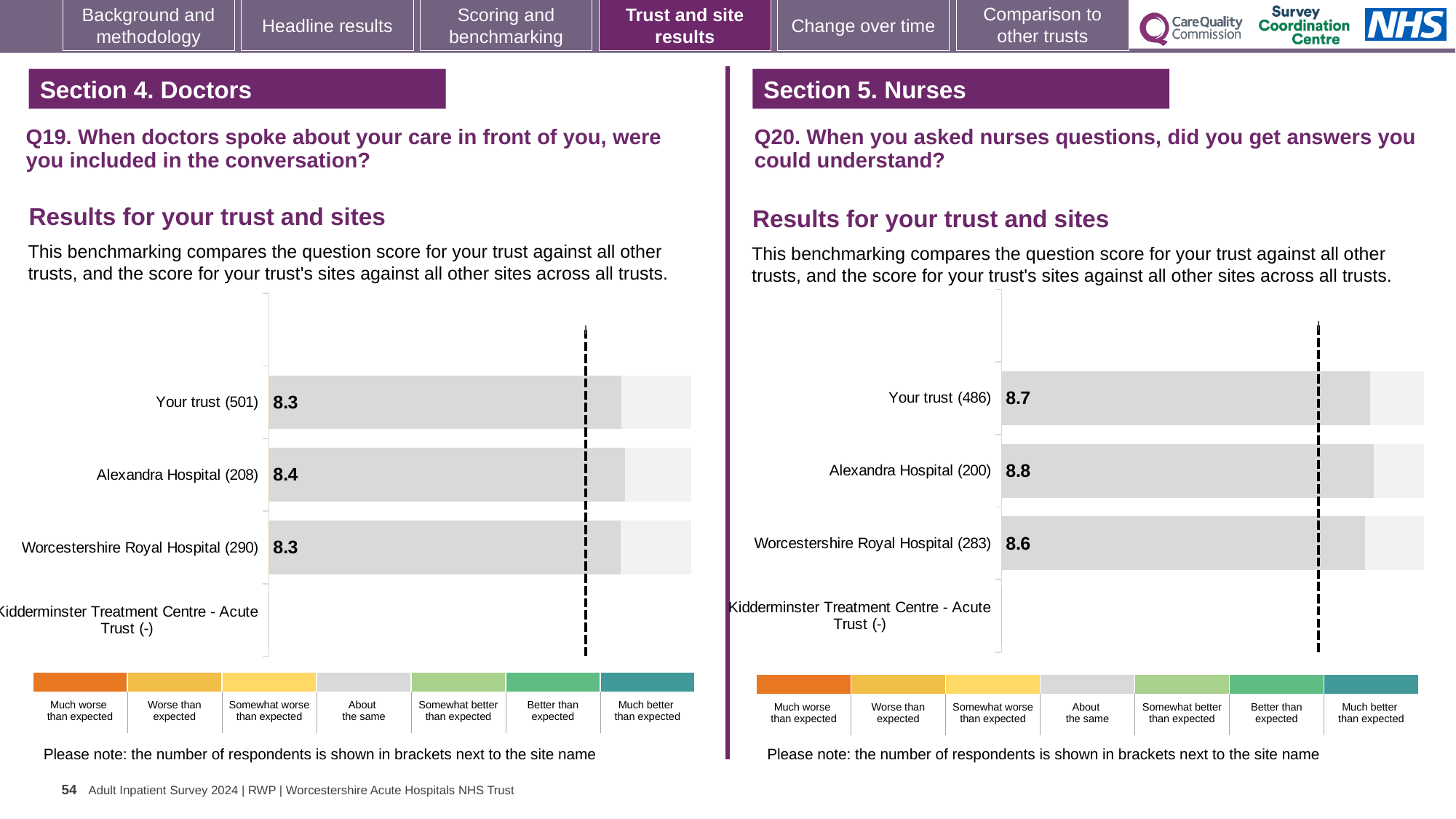
In the Q19 chart on the left, what is the score for Alexandra Hospital (208)? 8.4 In the Q20 chart on the right, what is the score for Your trust (486)? 8.7 How many categories are listed on the y axis of the Q19 chart on the left? 4 In the Q19 chart on the left, which category has no score shown? Kidderminster Treatment Centre - Acute Trust (-) In the Q19 chart on the left, which site has the highest score? Alexandra Hospital (208) In the Q20 chart on the right, which site has the lowest score among those with a score shown? Worcestershire Royal Hospital (283) In the Q20 chart on the right, what is the difference between the scores for Alexandra Hospital (200) and Worcestershire Royal Hospital (283)? 0.2 In the Q20 chart on the right, what is the score for Worcestershire Royal Hospital (283)? 8.6 What kind of chart is the Q20 chart on the right? Bar chart In the Q19 chart on the left, what is the score for Your trust (501)? 8.3 In the Q20 chart on the right, which site has the highest score? Alexandra Hospital (200) In the Q19 chart on the left, which has the larger score: Alexandra Hospital (208) or Worcestershire Royal Hospital (290)? Alexandra Hospital (208)